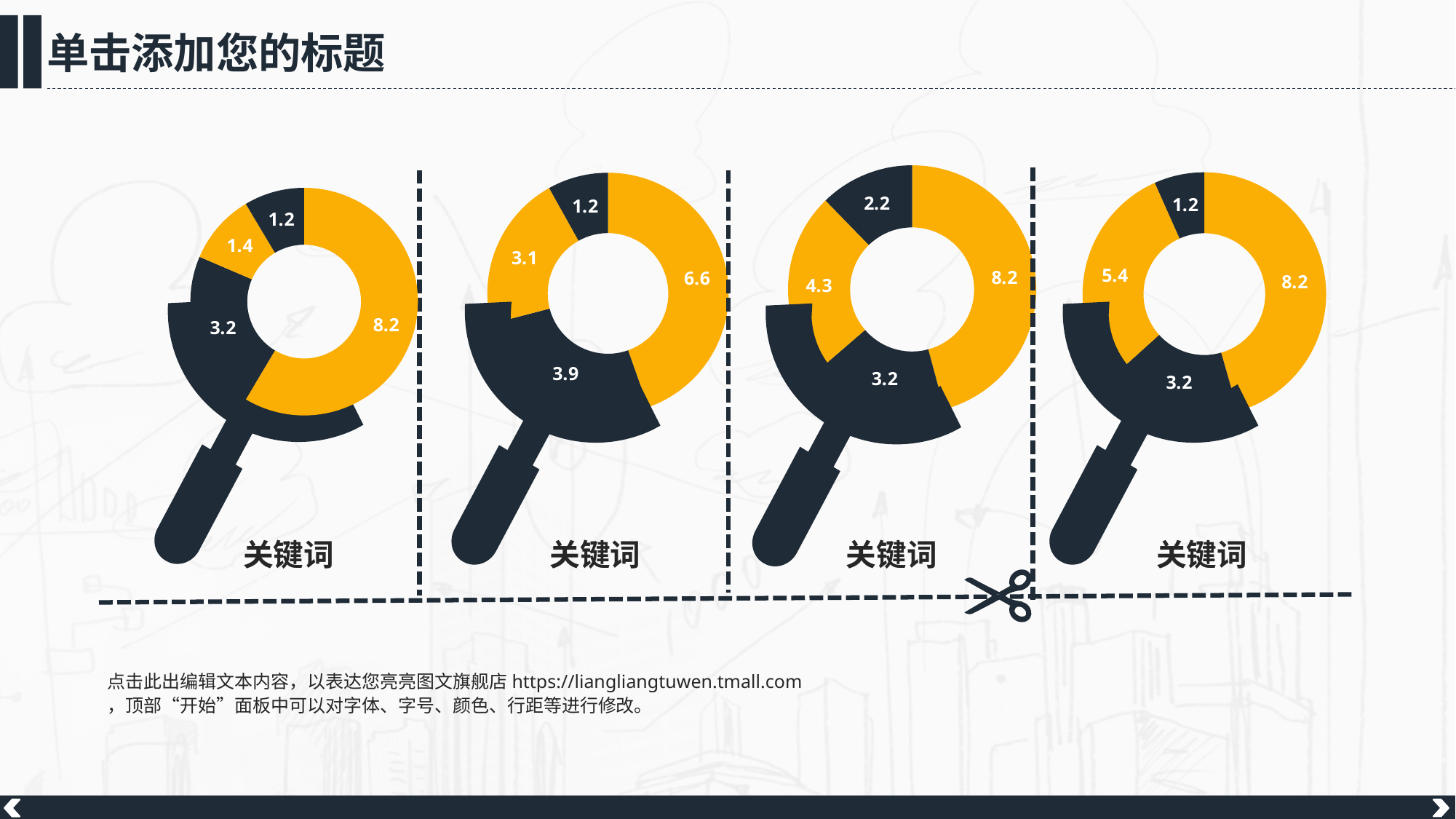
In the leftmost doughnut chart, what is the value of the largest slice? 8.2 In the second doughnut chart from the left, what is the difference between the largest slice (6.6) and the smallest slice (1.2)? 5.4 In the third doughnut chart from the left, what is the value of the smallest slice? 2.2 In the rightmost doughnut chart, what is the value of the second-largest slice? 5.4 In the leftmost doughnut chart, what is the value of the smallest slice? 1.2 How many slices does the leftmost doughnut chart have? 4 In the third doughnut chart from the left, what is the sum of all four slice values? 17.9 What kind of chart is the leftmost chart on the slide? Doughnut chart How many doughnut charts are shown on the slide? 4 What two colours are used for the slices in the doughnut charts? Yellow-orange and dark navy Which has a larger biggest slice: the leftmost doughnut chart (8.2) or the second doughnut chart from the left (6.6)? The leftmost chart In the second doughnut chart from the left, what is the value of the largest slice? 6.6